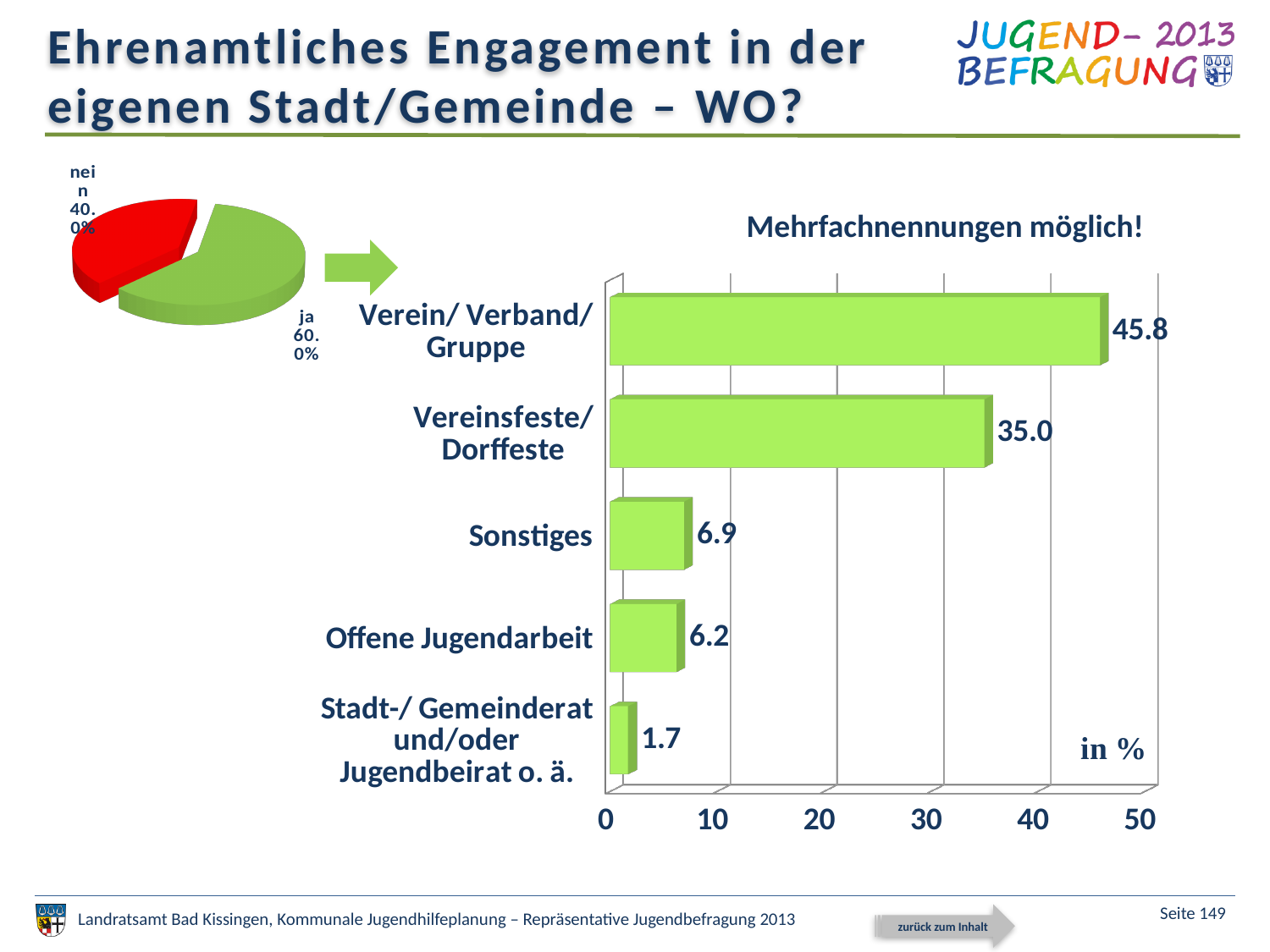
In the bar chart, what is the value for Stadt-/ Gemeinderat und/oder Jugendbeirat o. ä.? 1.7 In the bar chart, which is larger: the value for Sonstiges or for Offene Jugendarbeit? Sonstiges In the pie chart, what share does the 'nein' slice have? 40.0% In the bar chart, what is the value for Verein/ Verband/ Gruppe? 45.8 In the bar chart, which category has the highest value? Verein/ Verband/ Gruppe In the pie chart, what share does the 'ja' slice have? 60.0% What kind of chart is the chart on the right side of the slide? bar chart How many categories does the bar chart show? 5 In the bar chart, which category has the lowest value? Stadt-/ Gemeinderat und/oder Jugendbeirat o. ä. What is the highest tick value shown on the x axis of the bar chart? 50 In the bar chart, what is the value for Vereinsfeste/ Dorffeste? 35.0 In the bar chart, what is the difference between the values for Verein/ Verband/ Gruppe and Vereinsfeste/ Dorffeste? 10.8